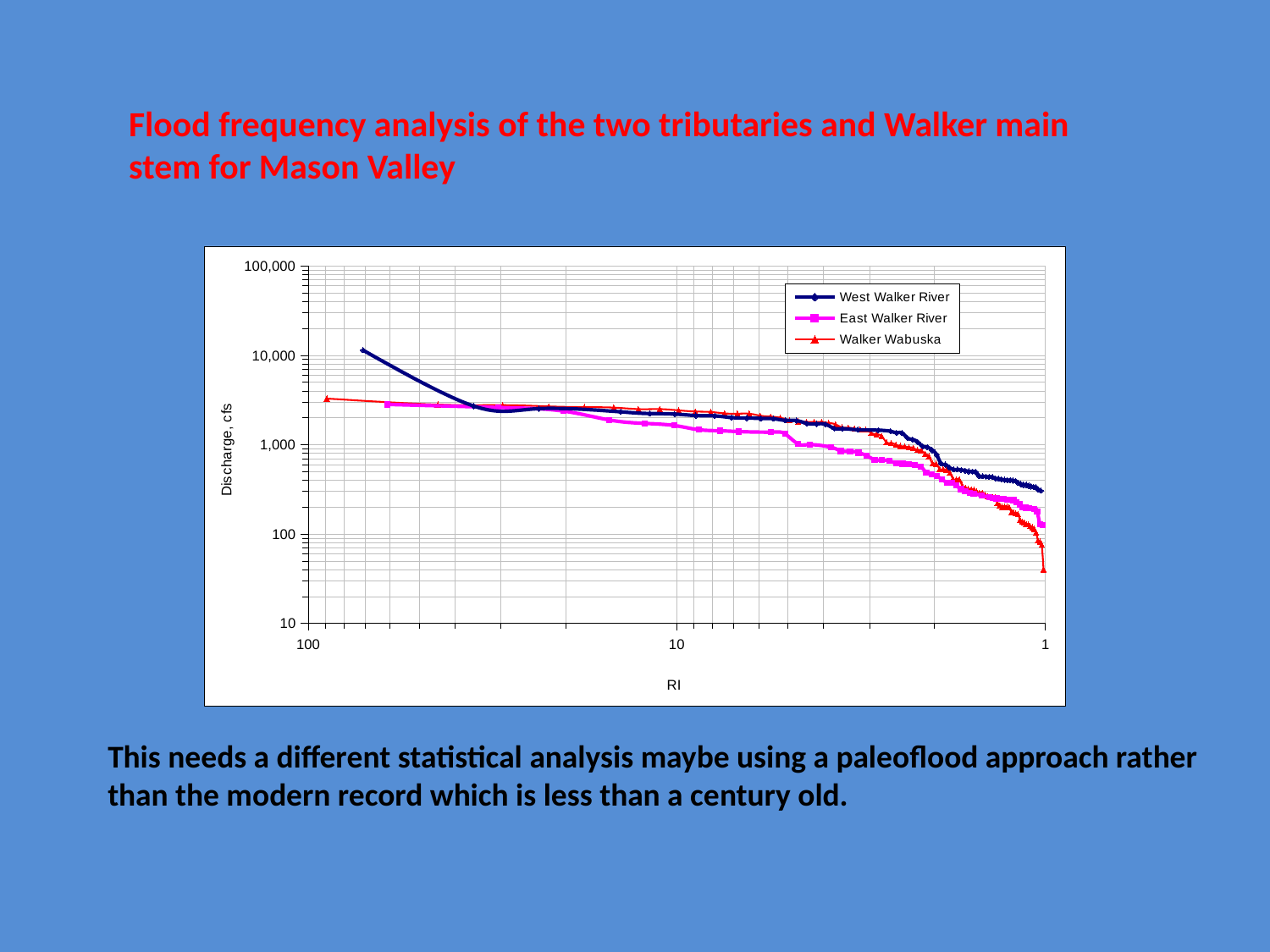
Is the value for East Walker River at RI = 1 greater or less than 1,000 cfs? less Which series reaches the highest discharge value on the chart? West Walker River At RI = 1, which series has the higher discharge, West Walker River or Walker Wabuska? West Walker River Moving from left to right along the x axis (from RI = 100 to RI = 1), do the discharge values rise or fall? fall Which series is drawn in magenta with square markers? East Walker River Is the highest value for West Walker River greater or less than 1,000 cfs? greater At RI = 10, which series has the higher discharge, West Walker River or East Walker River? West Walker River What is the label on the vertical axis of the chart? Discharge, cfs Is the lowest value for Walker Wabuska greater or less than 100 cfs? less How many series does the chart legend list? 3 Which series reaches the lowest discharge value on the chart? Walker Wabuska What kind of chart is shown on the slide? line chart